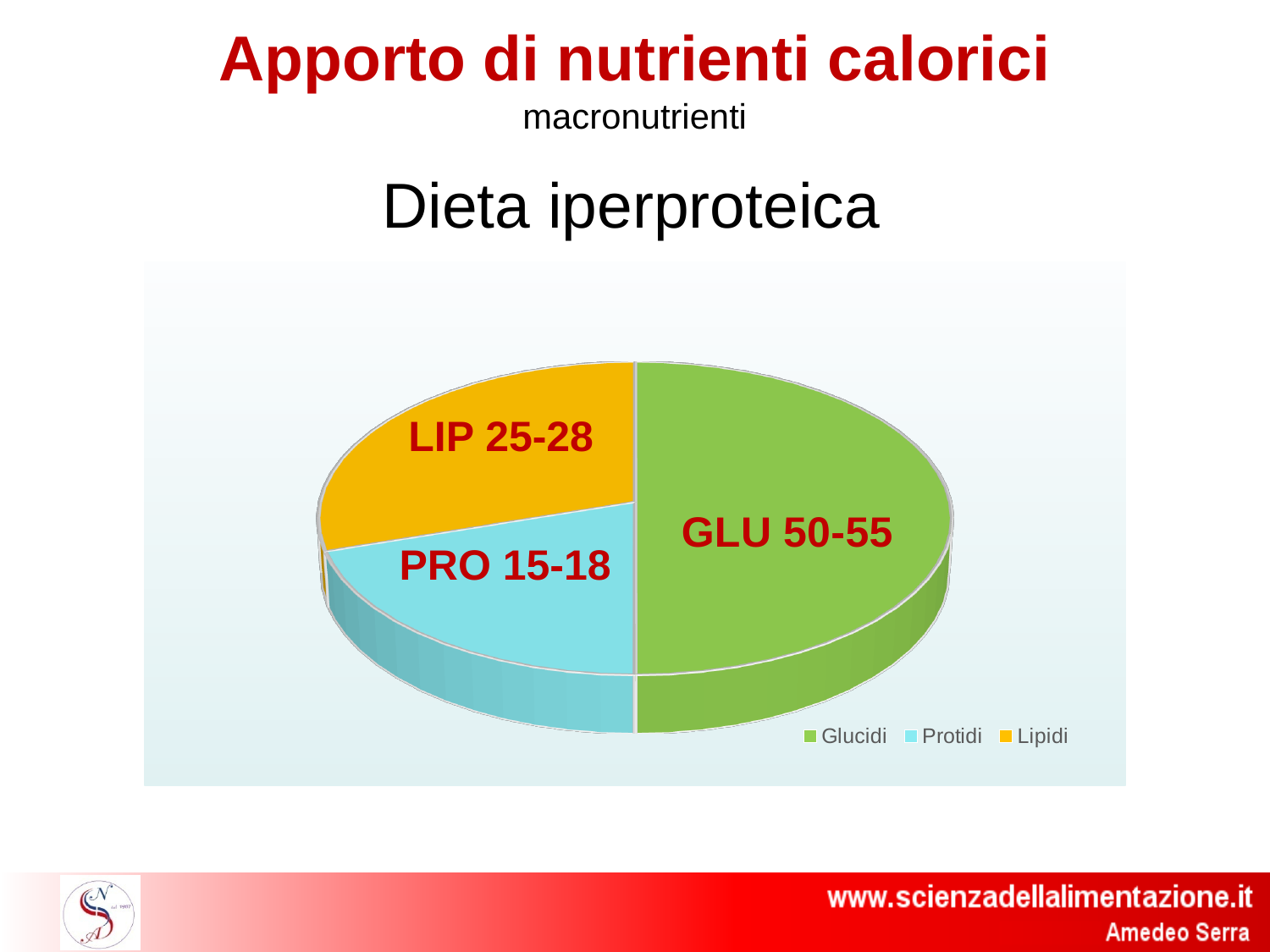
What label is printed on the light blue slice of the pie chart? PRO 15-18 What label is printed on the green slice of the pie chart? GLU 50-55 What label is printed on the orange slice of the pie chart? LIP 25-28 Which slice of the pie chart is the smallest? Protidi Which colour represents Protidi in the pie chart? light blue What range is shown for Lipidi (LIP) in the pie chart? 25-28 What diet does the pie chart describe, according to the heading above it? Dieta iperproteica Which slice is larger in the pie chart, Lipidi or Protidi? Lipidi Which slice of the pie chart is the largest? Glucidi What kind of chart is shown on the slide? pie chart How many entries does the legend of the pie chart list? 3 How many slices does the pie chart have? 3